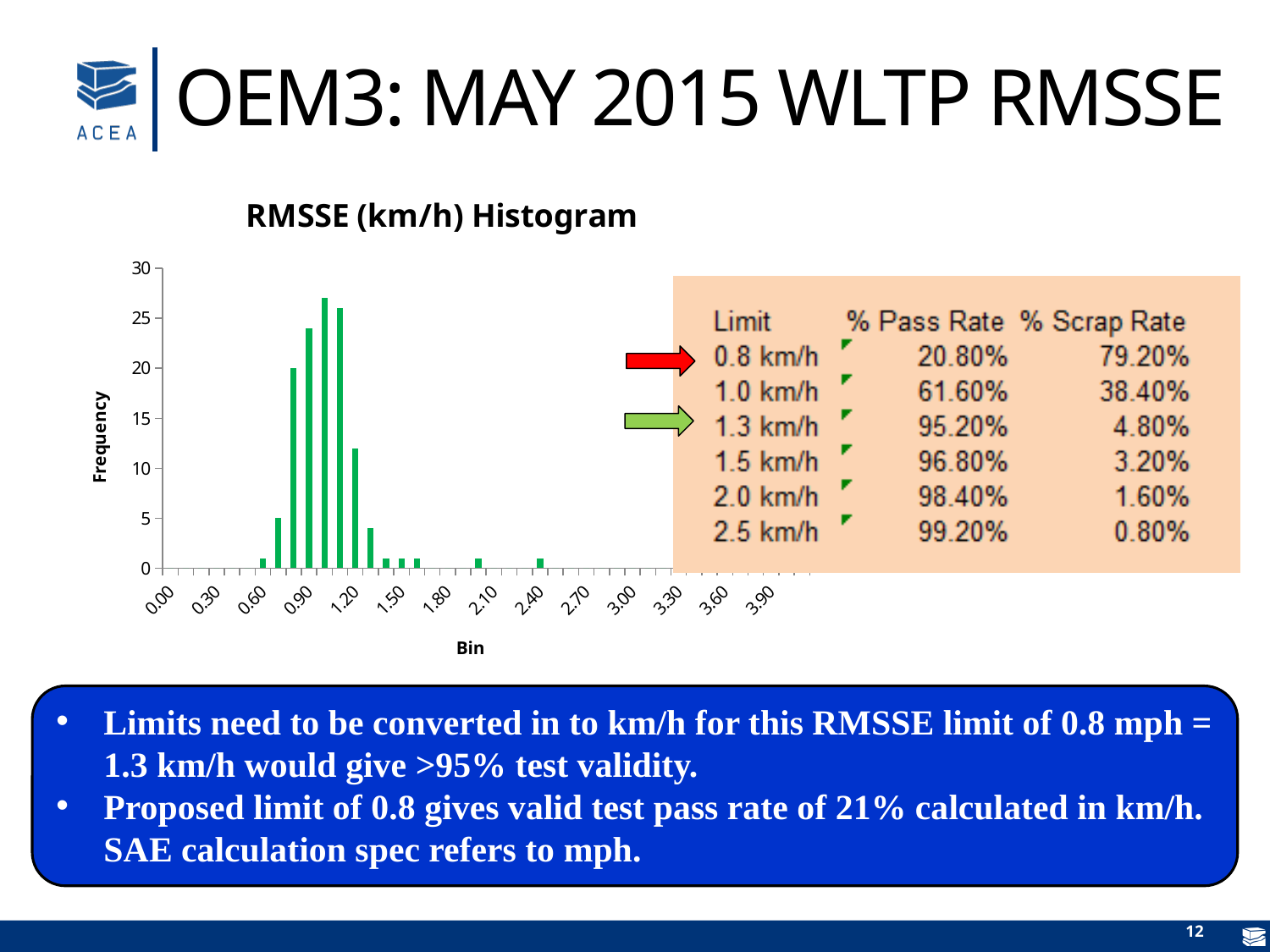
Which bin has the higher frequency, 0.80 or 1.20? 0.80 Is the frequency for bin 1.00 greater or less than 25? greater Do the frequencies rise or fall from bin 1.00 to bin 1.30? fall Is the frequency for bin 1.30 greater or less than 5? less What is the title of the chart? RMSSE (km/h) Histogram Do the frequencies rise or fall from bin 0.60 to bin 1.00? rise What kind of chart is shown on the slide? Bar chart Is the frequency for bin 1.20 greater or less than 10? greater What are the titles of the x axis and the y axis of the chart? Bin (x axis) and Frequency (y axis) Which bin has the higher frequency, 0.90 or 1.30? 0.90